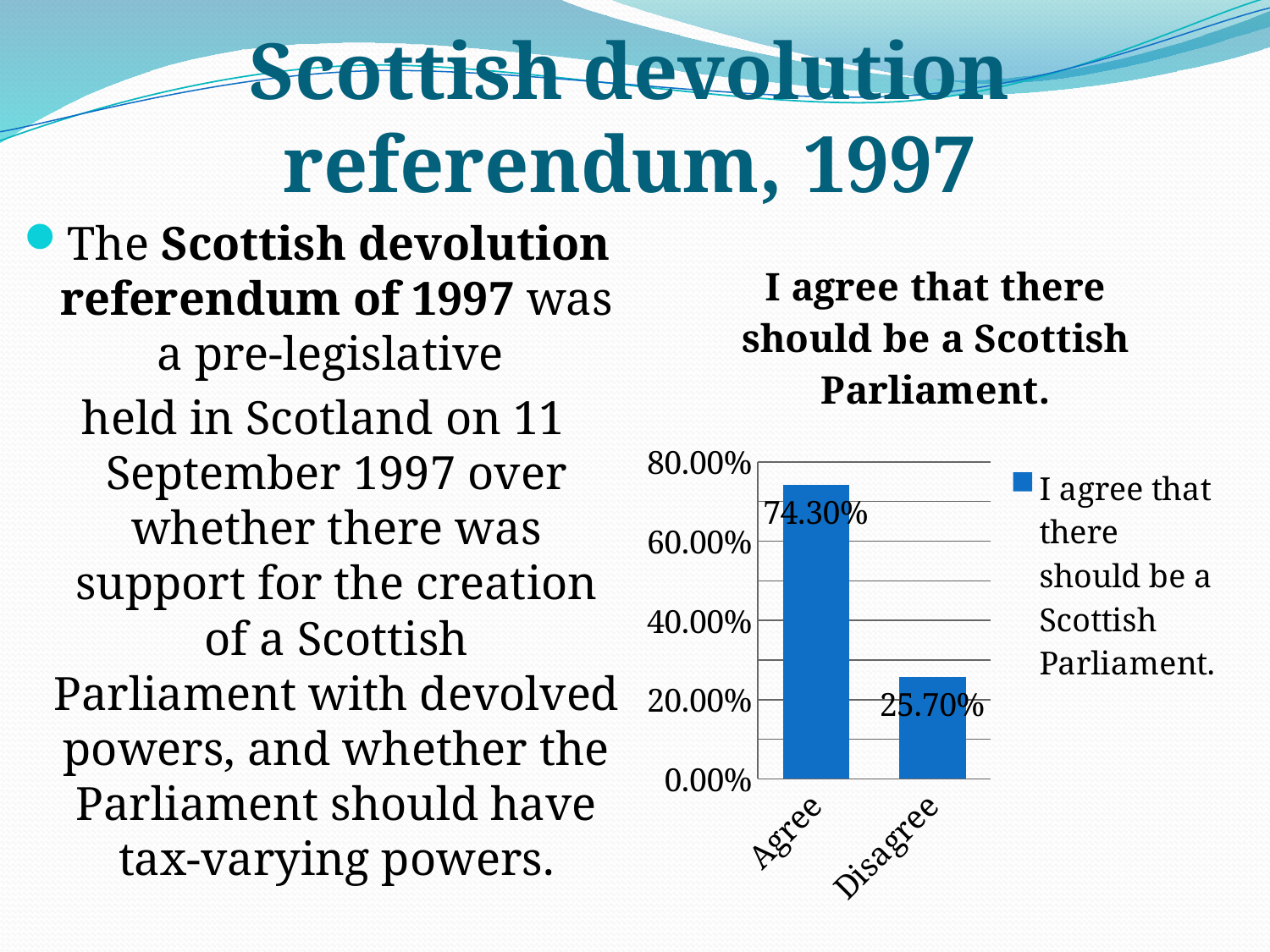
What is the title of the chart? I agree that there should be a Scottish Parliament. Which category has the highest value? Agree Is the value for Disagree greater or less than 40.00%? less Which category has the lowest value? Disagree Is the value for Agree greater or less than 60.00%? greater Which is larger, the value for Agree or the value for Disagree? Agree What is the value for Agree? 74.30% How many categories are shown on the x axis? 2 What kind of chart is shown on the slide? bar chart What is the value for Disagree? 25.70% What is the difference between the values for Agree and Disagree? 48.60% How many series does the legend list? 1